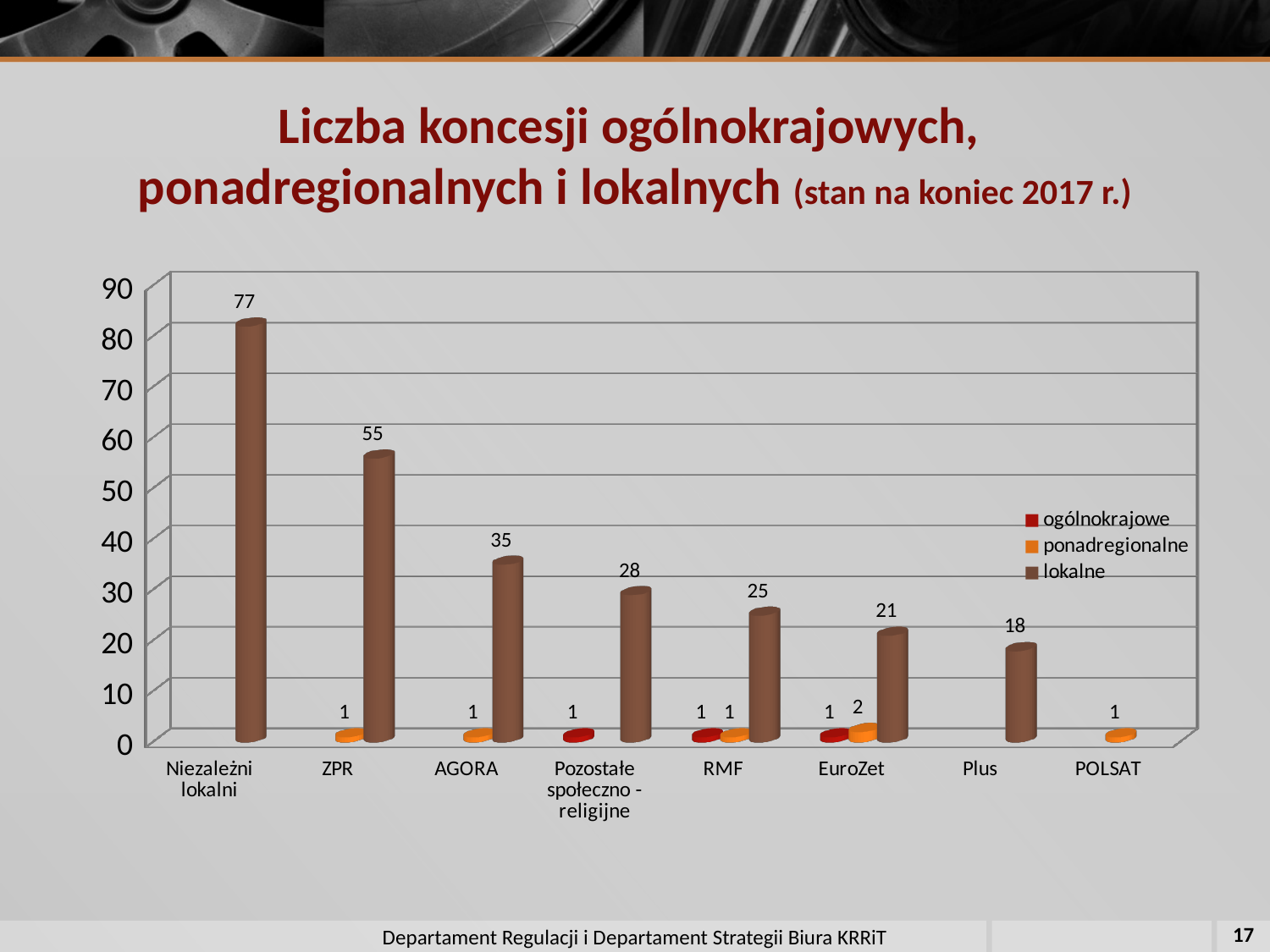
How many series does the legend list? 3 What is the difference between the lokalne values for ZPR and AGORA? 20 What is the value of the lokalne series for ZPR? 55 What is the value of the ponadregionalne series for EuroZet? 2 What is the value of the lokalne series for Niezależni lokalni? 77 Which series is shown in orange in the legend? ponadregionalne Which category has the lowest lokalne value among those with a lokalne bar? Plus Which is larger, the lokalne value for RMF or for EuroZet? RMF What is the value of the lokalne series for Plus? 18 How many categories are shown on the x axis? 8 Which category has the highest lokalne value? Niezależni lokalni What kind of chart is shown on the slide? Bar chart